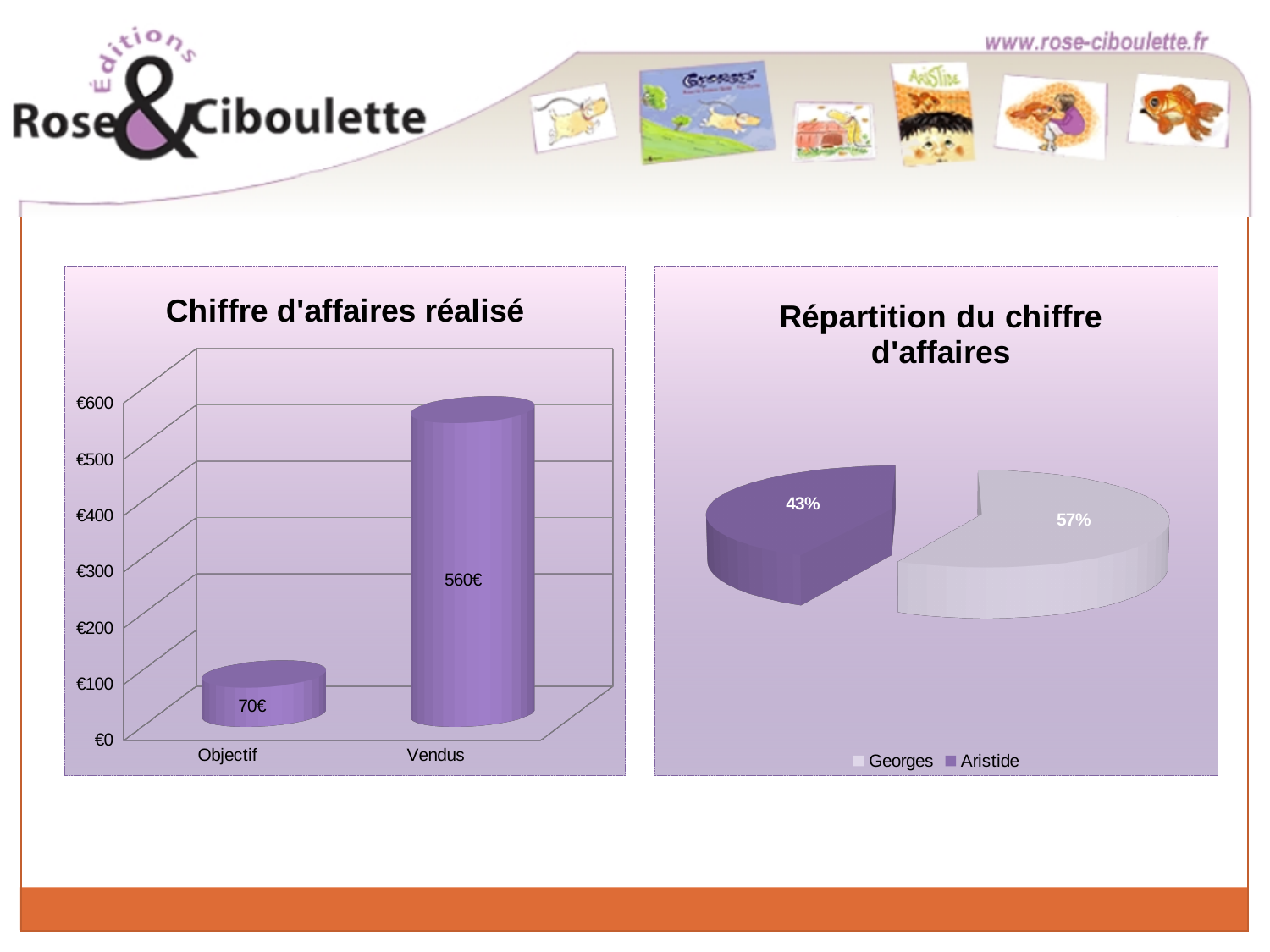
In the 'Chiffre d'affaires réalisé' chart, what is the value for Objectif? 70€ In the 'Chiffre d'affaires réalisé' chart, what is the value for Vendus? 560€ In the 'Chiffre d'affaires réalisé' chart, how many categories are shown? 2 In the 'Chiffre d'affaires réalisé' chart, what is the difference between Vendus and Objectif? 490€ In the 'Répartition du chiffre d'affaires' chart, what share does Georges have? 57% What kind of chart is 'Chiffre d'affaires réalisé'? Bar chart In the 'Répartition du chiffre d'affaires' chart, what share does Aristide have? 43% In the 'Chiffre d'affaires réalisé' chart, which category has the highest value? Vendus In the 'Chiffre d'affaires réalisé' chart, which category has the lowest value? Objectif In the 'Répartition du chiffre d'affaires' chart, how many entries does the legend list? 2 In the 'Répartition du chiffre d'affaires' chart, which slice is larger, Georges or Aristide? Georges What kind of chart is 'Répartition du chiffre d'affaires'? Pie chart